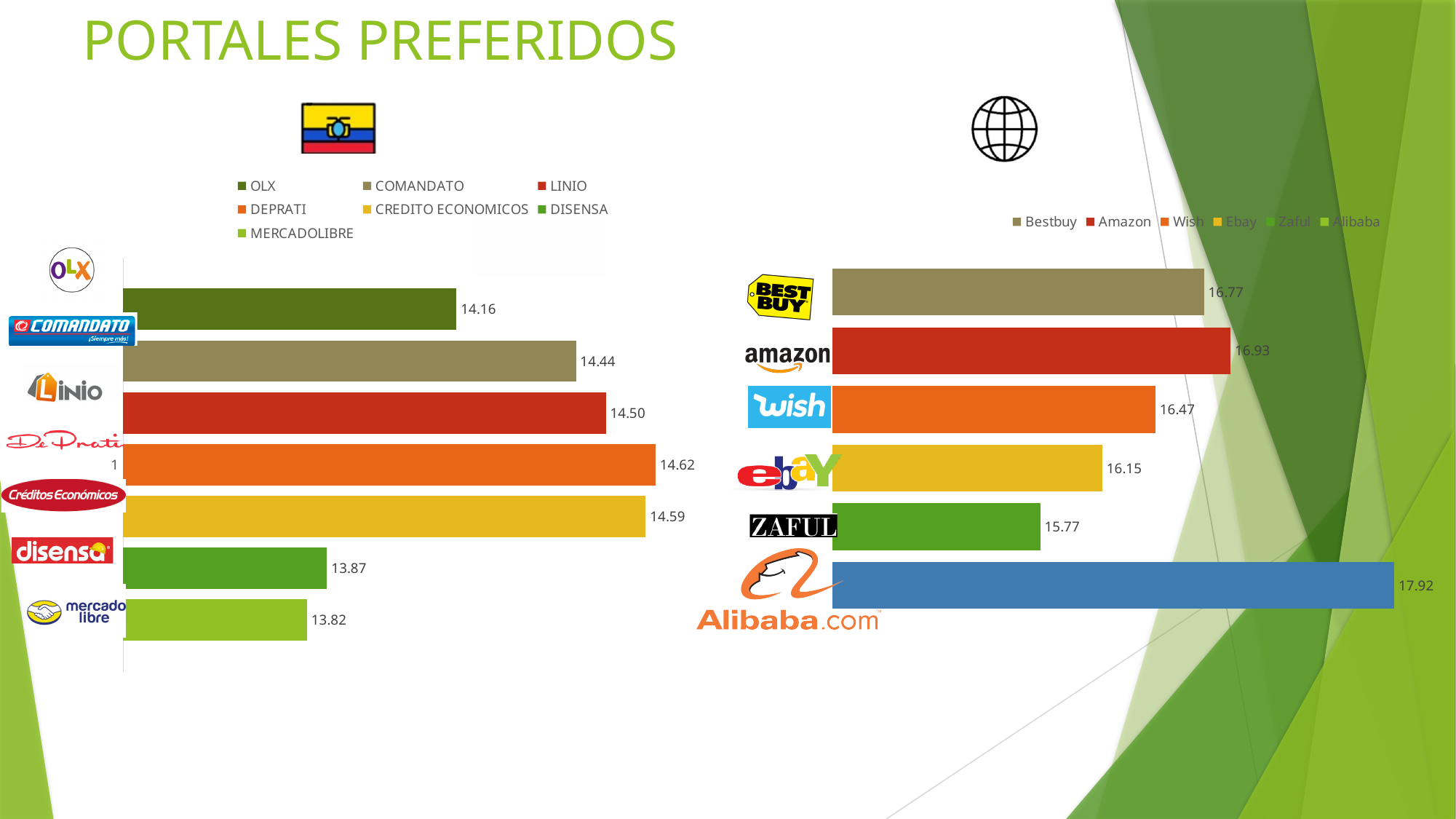
On the right chart, which portal has the highest value? Alibaba On the left chart, what is the difference between the values for COMANDATO and OLX? 0.28 How many entries does the legend of the right chart list? 6 On the right chart, which portal has the lowest value? Zaful On the left chart, how many portals are plotted? 7 On the left chart, which portal has the lowest value? MERCADOLIBRE On the left chart, which portal has the highest value? DEPRATI On the left chart, what is the value for MERCADOLIBRE? 13.82 On the right chart, what is the difference between the values for Alibaba and Ebay? 1.77 On the right chart, which is larger, the value for Amazon or the value for Bestbuy? Amazon On the left chart, what is the value for LINIO? 14.50 On the right chart, what is the value for Wish? 16.47